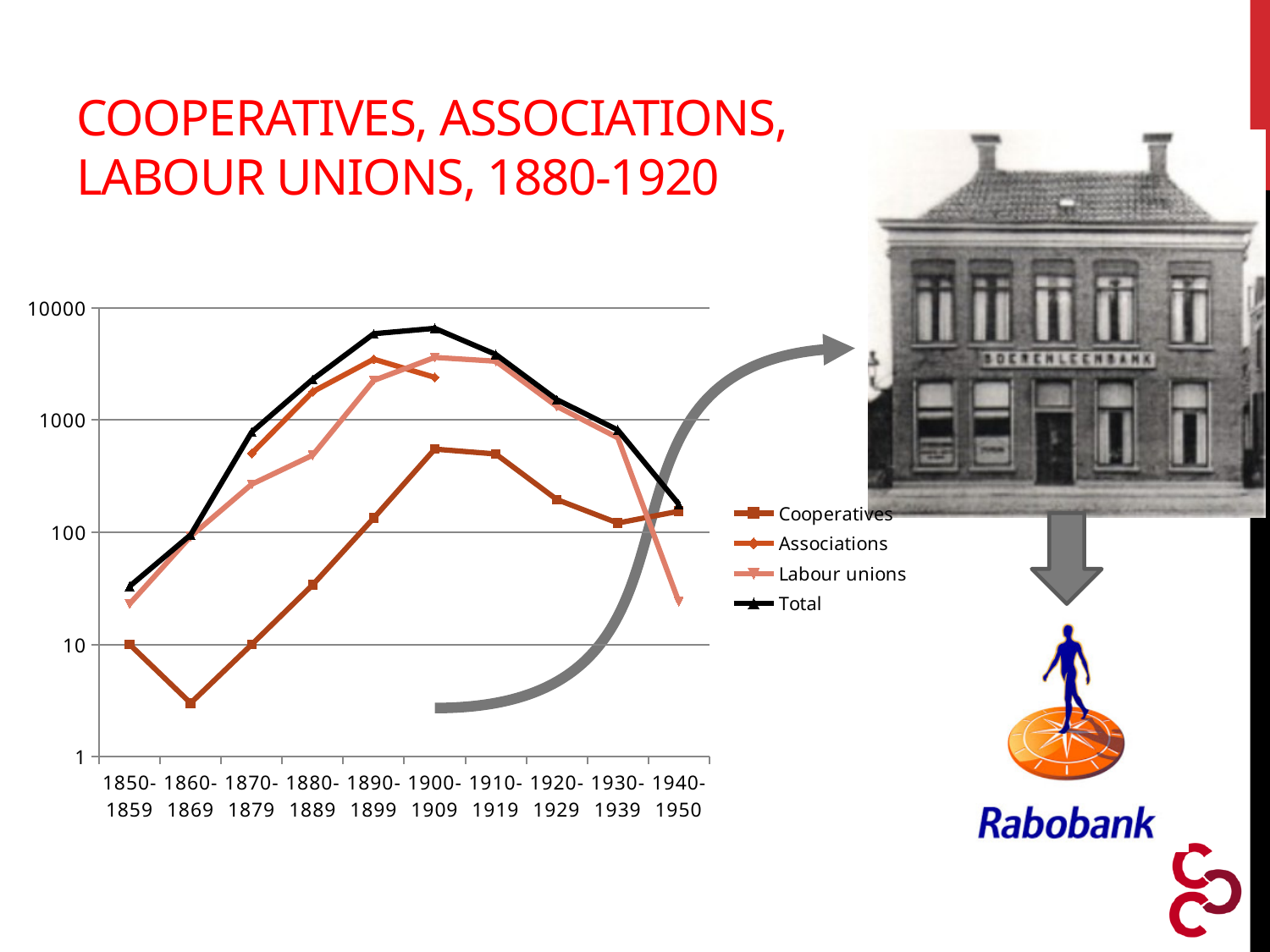
In which period does the Cooperatives series reach its lowest value? 1860-1869 In 1890-1899, which is larger: Associations or Cooperatives? Associations Is the Total value for 1900-1909 greater or less than 1000? greater How many time periods are shown along the x axis of the chart? 10 What kind of chart is shown on the slide? line chart How many series does the chart's legend list? 4 Is the Cooperatives value for 1860-1869 greater or less than 10? less In which period does the Total series reach its highest value? 1900-1909 What are the four series listed in the chart's legend? Cooperatives, Associations, Labour unions, Total Which series is drawn in black on the chart? Total Does the Total series rise or fall from 1900-1909 to 1940-1950? fall Is the Labour unions value for 1940-1950 greater or less than 100? less